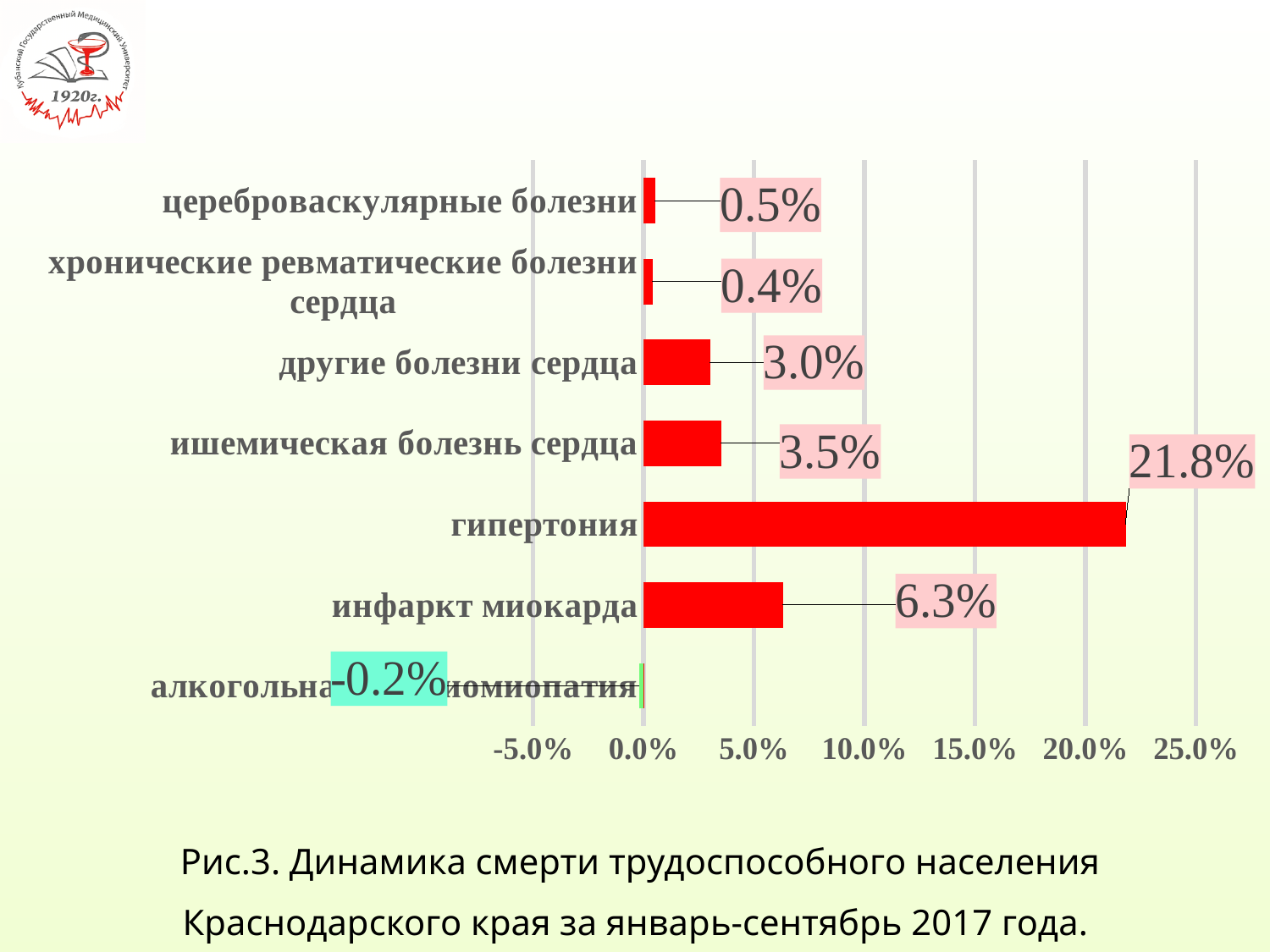
What is the value for алкогольная кардиомиопатия? -0.2% Which category has the highest value? гипертония What is the value for гипертония? 21.8% What kind of chart is shown on the slide? bar chart What is the difference between the values for гипертония and инфаркт миокарда? 15.5% What is the value for инфаркт миокарда? 6.3% Which is larger, the value for ишемическая болезнь сердца or the value for другие болезни сердца? ишемическая болезнь сердца What is the value for ишемическая болезнь сердца? 3.5% What is the value for хронические ревматические болезни сердца? 0.4% How many categories are shown in the chart? 7 Which category has the lowest value? алкогольная кардиомиопатия Is the value for гипертония greater or less than 20.0%? greater